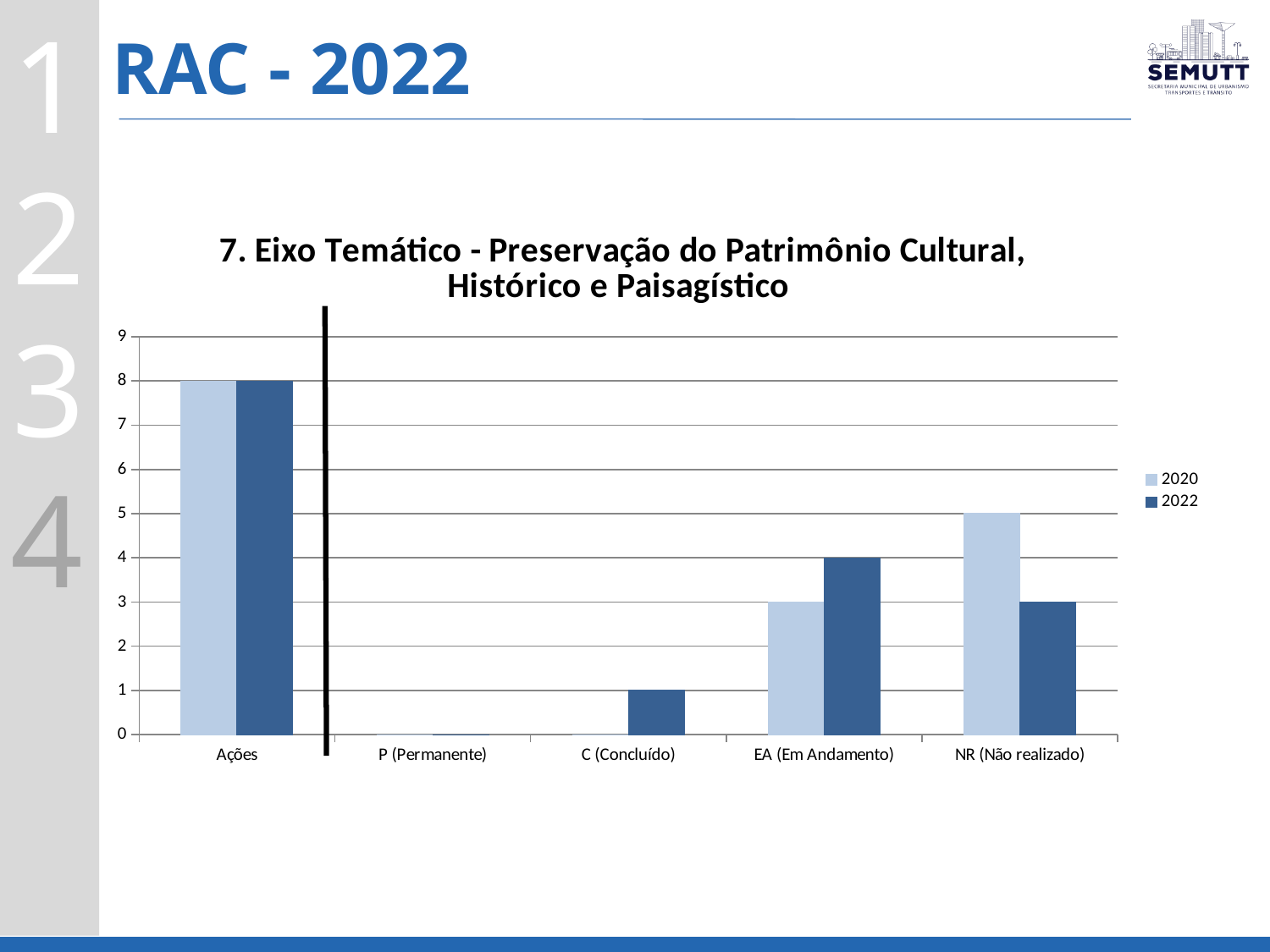
What kind of chart is shown on the slide? bar chart What is the value for EA (Em Andamento) in the 2020 series? 3 Which category has the highest value in the 2020 series? Ações What is the difference between the 2020 and 2022 values for NR (Não realizado)? 2 What is the title of the chart? 7. Eixo Temático - Preservação do Patrimônio Cultural, Histórico e Paisagístico What is the value for Ações in the 2022 series? 8 What is the value for C (Concluído) in the 2022 series? 1 How many categories are shown on the x axis? 5 What is the value for NR (Não realizado) in the 2022 series? 3 How many series does the legend list? 2 Which is larger for EA (Em Andamento): the 2020 value or the 2022 value? 2022 Is the value for NR (Não realizado) in the 2020 series greater or less than 4? greater